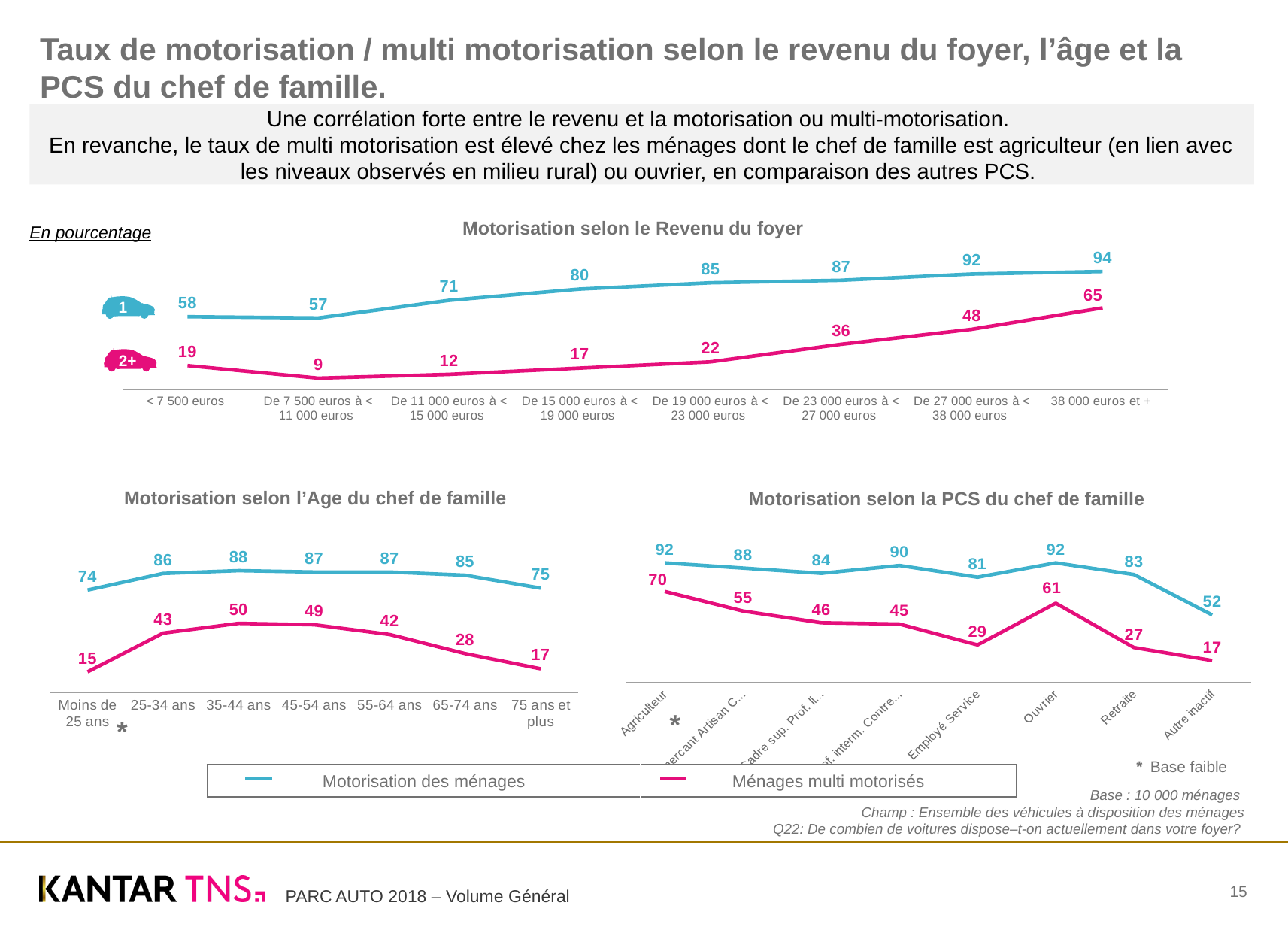
In the chart 'Motorisation selon l'Age du chef de famille', what is the value of 'Ménages multi motorisés' for '35-44 ans'? 50 In the chart 'Motorisation selon le Revenu du foyer', which income category has the lowest value for 'Ménages multi motorisés'? De 7 500 euros à < 11 000 euros In the chart 'Motorisation selon la PCS du chef de famille', which category has the lowest value for 'Motorisation des ménages'? Autre inactif What type of chart is 'Motorisation selon la PCS du chef de famille'? Line chart In the chart 'Motorisation selon la PCS du chef de famille', what is the value of 'Ménages multi motorisés' for 'Ouvrier'? 61 In the chart 'Motorisation selon l'Age du chef de famille', which is larger for 'Ménages multi motorisés': 'Moins de 25 ans' or '75 ans et plus'? 75 ans et plus In the chart 'Motorisation selon l'Age du chef de famille', which age group has the highest value for 'Motorisation des ménages'? 35-44 ans In the chart 'Motorisation selon le Revenu du foyer', what is the difference between 'Motorisation des ménages' and 'Ménages multi motorisés' for '38 000 euros et +'? 29 How many series does the legend list for the charts on this slide? 2 How many income categories are shown in the chart 'Motorisation selon le Revenu du foyer'? 8 In the chart 'Motorisation selon le Revenu du foyer', what is the value of 'Ménages multi motorisés' for 'De 7 500 euros à < 11 000 euros'? 9 In the chart 'Motorisation selon le Revenu du foyer', what is the value of 'Motorisation des ménages' for '38 000 euros et +'? 94